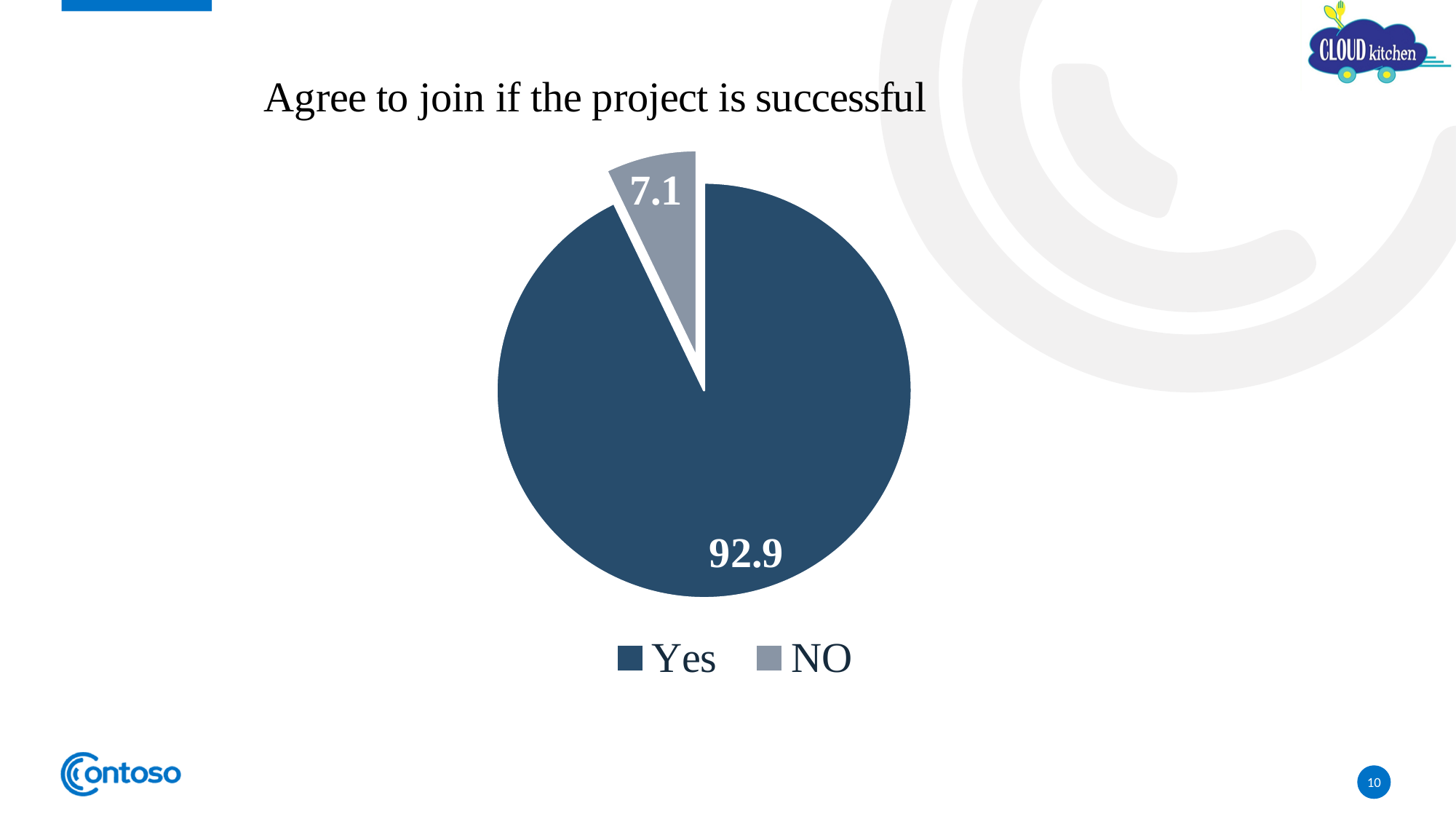
Which slice is pulled out from the pie? NO What is the total of the two slice values? 100 What kind of chart is shown on the slide? Pie chart What is the title of the chart? Agree to join if the project is successful Which category has the largest slice? Yes What is the value for Yes? 92.9 How many entries does the legend list? 2 What is the difference between the Yes and NO values? 85.8 How many slices does the pie chart have? 2 Which is larger, the value for Yes or the value for NO? Yes What is the value for NO? 7.1 Which category has the smallest slice? NO